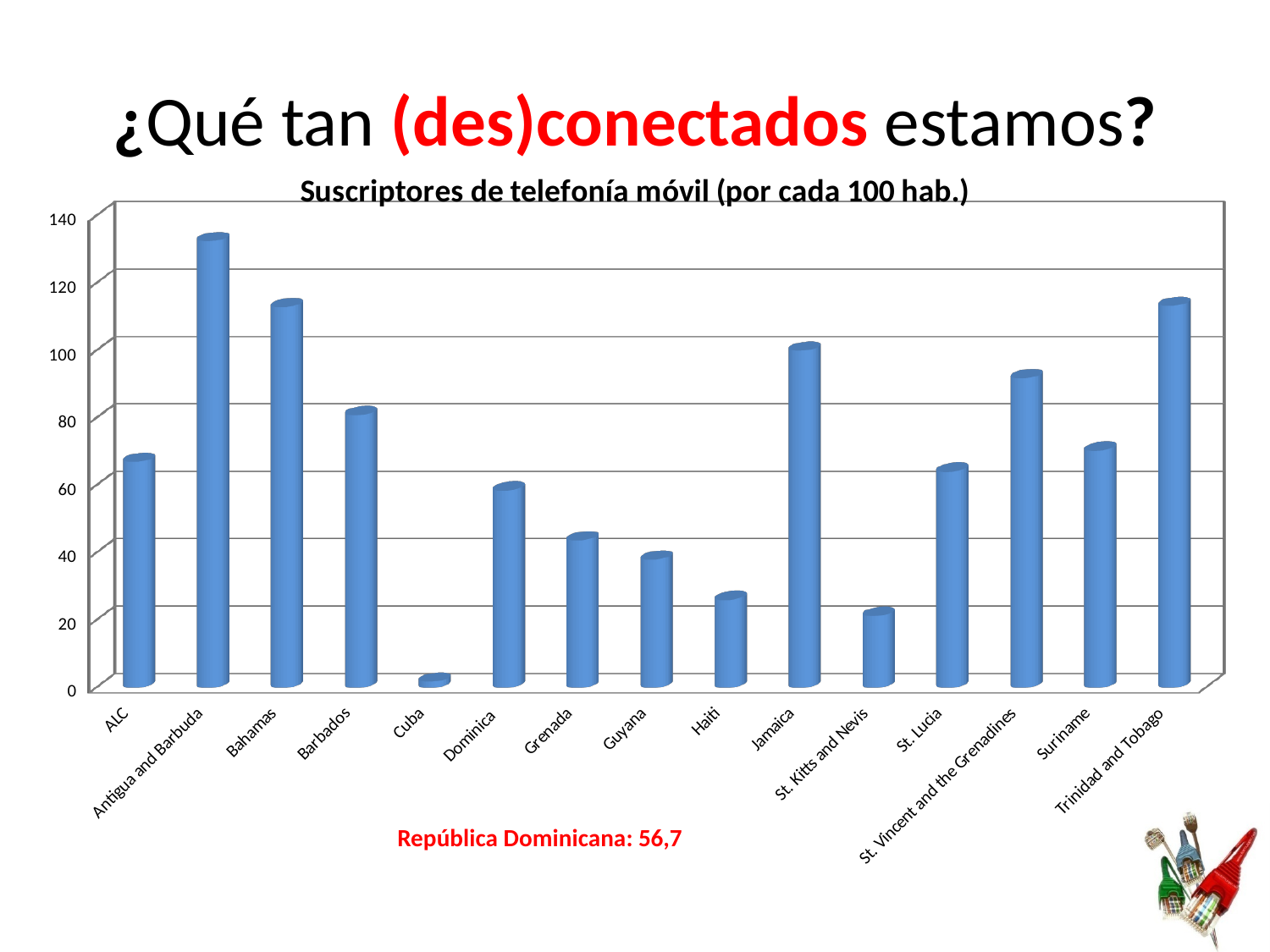
Which category has the highest value in the chart? Antigua and Barbuda Which category has the lowest value in the chart? Cuba Which is larger, the value for Jamaica or the value for Barbados? Jamaica Is the value for St. Vincent and the Grenadines greater or less than 80? greater How many countries/categories are plotted on the x axis of the chart? 15 What kind of chart is shown on the slide? bar chart Which is larger, the value for Grenada or the value for St. Kitts and Nevis? Grenada Is the value for Haiti greater or less than 40? less What value does the slide give for República Dominicana below the chart? 56,7 Is the value for Cuba greater or less than 20? less What is the title of the chart? Suscriptores de telefonía móvil (por cada 100 hab.)